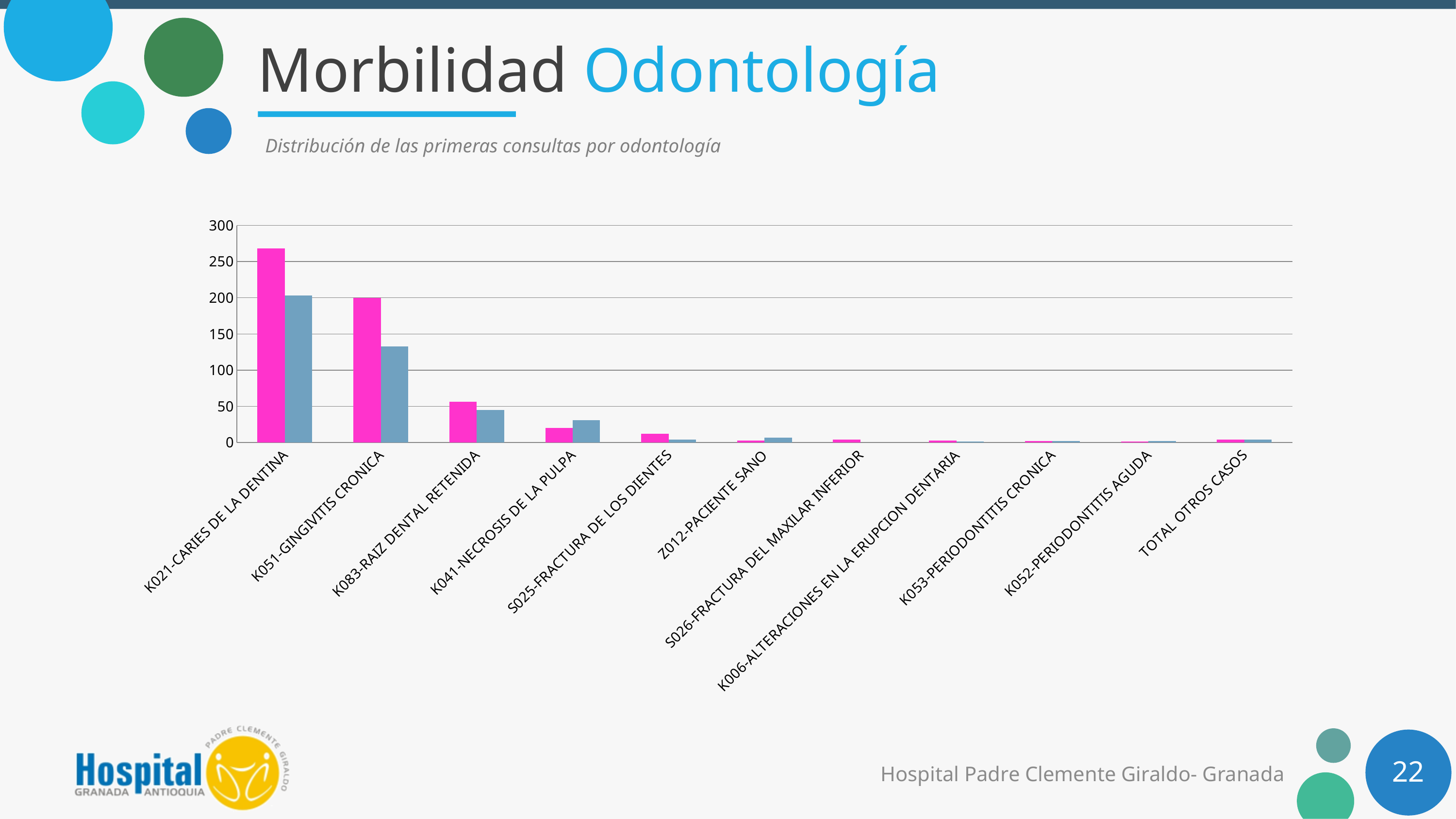
Do the values generally rise or fall moving from left to right along the x axis? fall Is the pink bar for K083-RAIZ DENTAL RETENIDA greater or less than 100? less Is the blue-grey bar for K051-GINGIVITIS CRONICA greater or less than 100? greater What kind of chart is shown on the slide? bar chart Is the pink bar for K021-CARIES DE LA DENTINA greater or less than 250? greater Which category has the tallest pink bar in the chart? K021-CARIES DE LA DENTINA How many categories are shown on the x axis of the chart? 11 How many bars are plotted for each category in the chart? 2 For K041-NECROSIS DE LA PULPA, which bar is taller, the pink one or the blue-grey one? the blue-grey one What is the subtitle text shown above the chart? Distribución de las primeras consultas por odontología For K021-CARIES DE LA DENTINA, which bar is taller, the pink one or the blue-grey one? the pink one